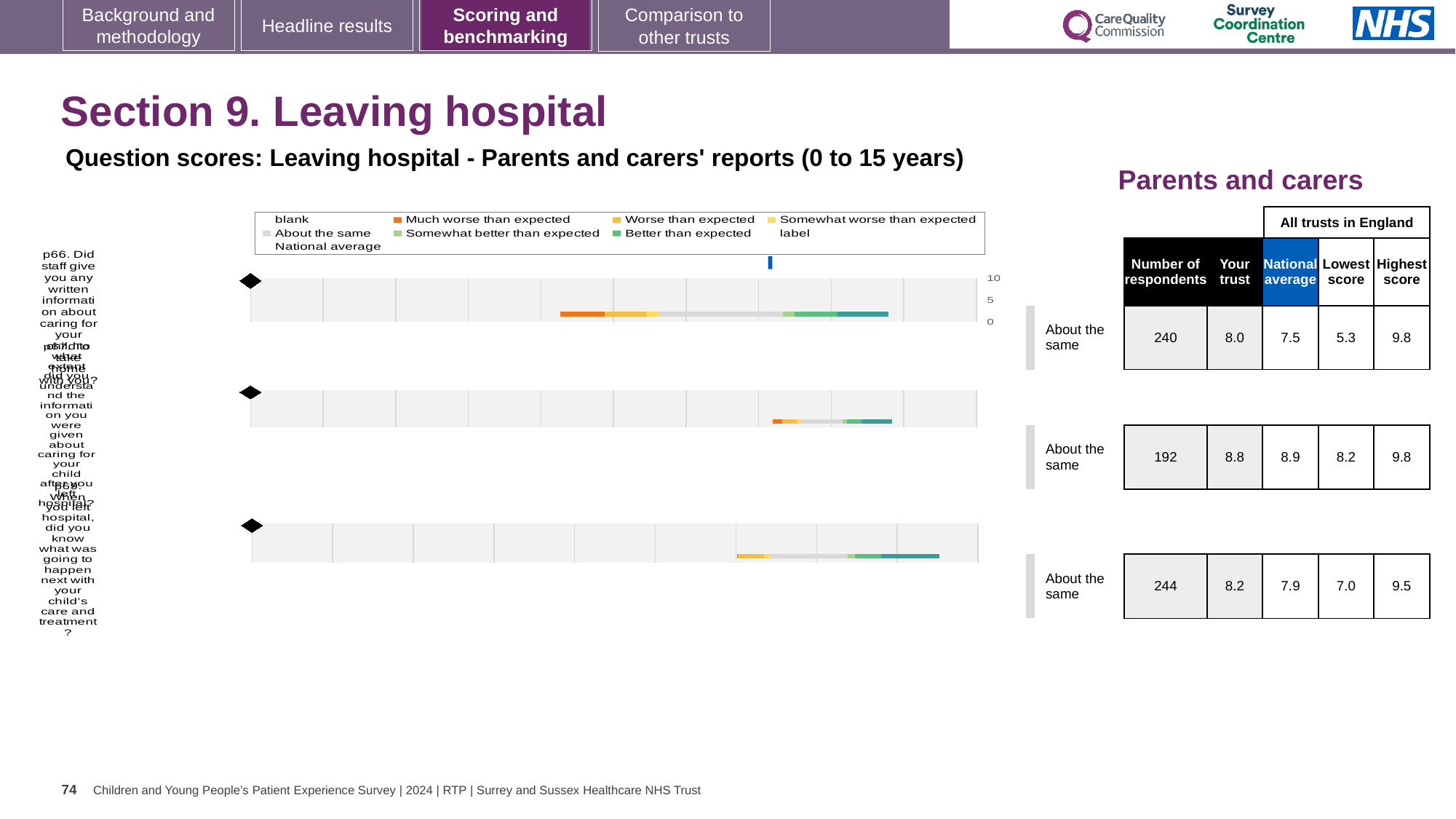
Which of the three questions has the highest number of respondents in the table? the third (bottom) question, 244 What benchmark category is shown beside each of the three bars? About the same How many question bars are plotted in the chart? 3 For the second (middle) question, is the 'Your trust' score higher or lower than the national average? lower In the table, what is the number of respondents for the first (top) question? 240 In the chart legend, which category is shown in orange? Much worse than expected In the table, what is the 'Your trust' score for the second (middle) question? 8.8 In the table, what is the national average for the third (bottom) question? 7.9 For the first (top) question, what is the difference between the 'Your trust' score and the national average? 0.5 In the table, what is the highest score for the third (bottom) question? 9.5 What kind of chart is used to show the question scores on this slide? bar chart In the table, what is the lowest score for the first (top) question? 5.3